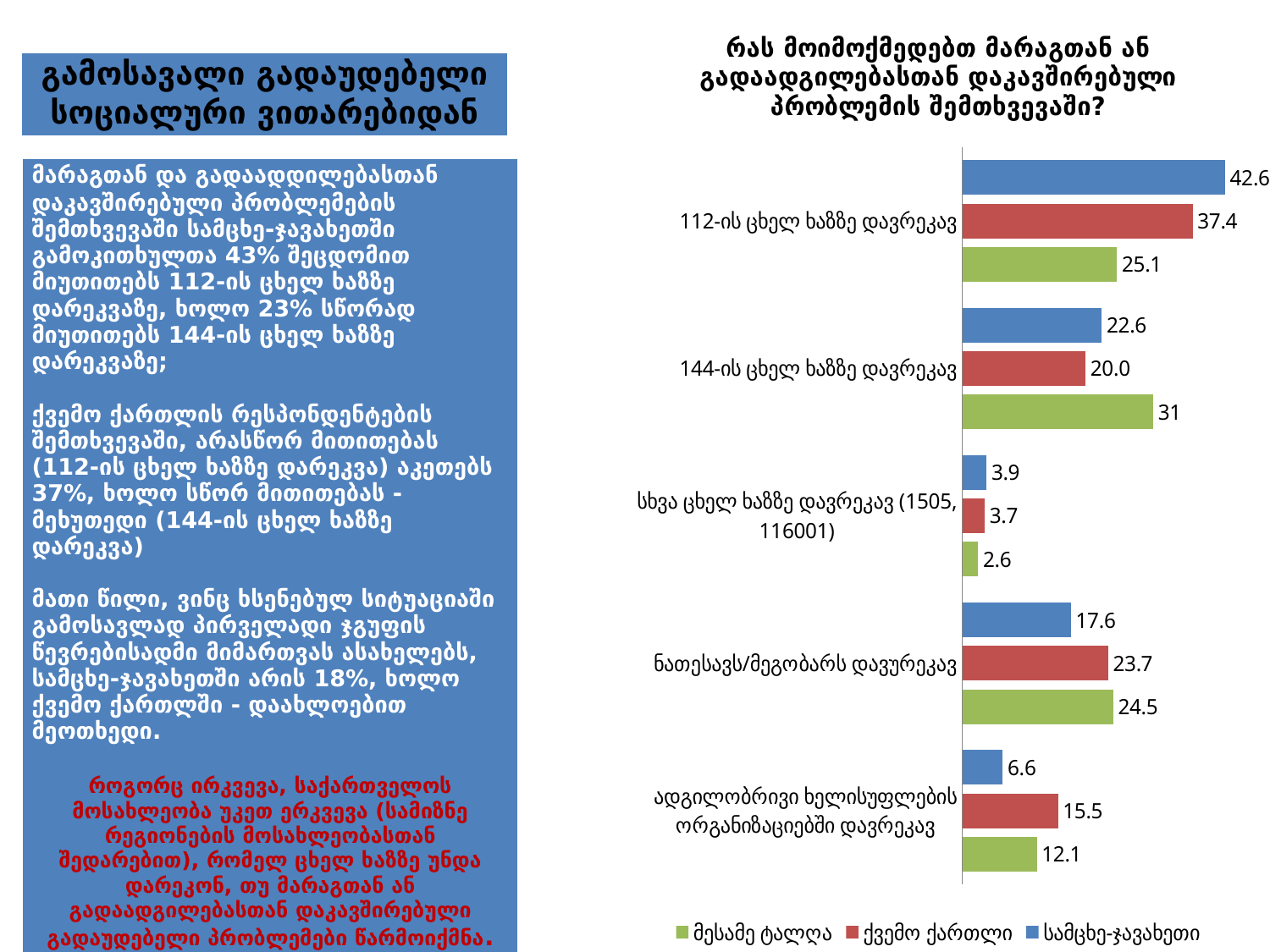
Which colour represents ქვემო ქართლი in the chart? Red What is the value for მესამე ტალღა in the category "ნათესავს/მეგობარს დავურეკავ"? 24.5 What is the value for სამცხე-ჯავახეთი in the category "112-ის ცხელ ხაზზე დავრეკავ"? 42.6 In the category "144-ის ცხელ ხაზზე დავრეკავ", which series has the larger value: მესამე ტალღა or სამცხე-ჯავახეთი? მესამე ტალღა Which category has the lowest value for მესამე ტალღა? სხვა ცხელ ხაზზე დავრეკავ (1505, 116001) What is the difference between the სამცხე-ჯავახეთი and ქვემო ქართლი values in the category "112-ის ცხელ ხაზზე დავრეკავ"? 5.2 How many series does the legend list? 3 What is the value for ქვემო ქართლი in the category "144-ის ცხელ ხაზზე დავრეკავ"? 20.0 What type of chart is shown on the slide? Bar chart Which category has the highest value for სამცხე-ჯავახეთი? 112-ის ცხელ ხაზზე დავრეკავ How many categories are shown on the chart? 5 What is the value for ქვემო ქართლი in the category "ადგილობრივი ხელისუფლების ორგანიზაციებში დავრეკავ"? 15.5